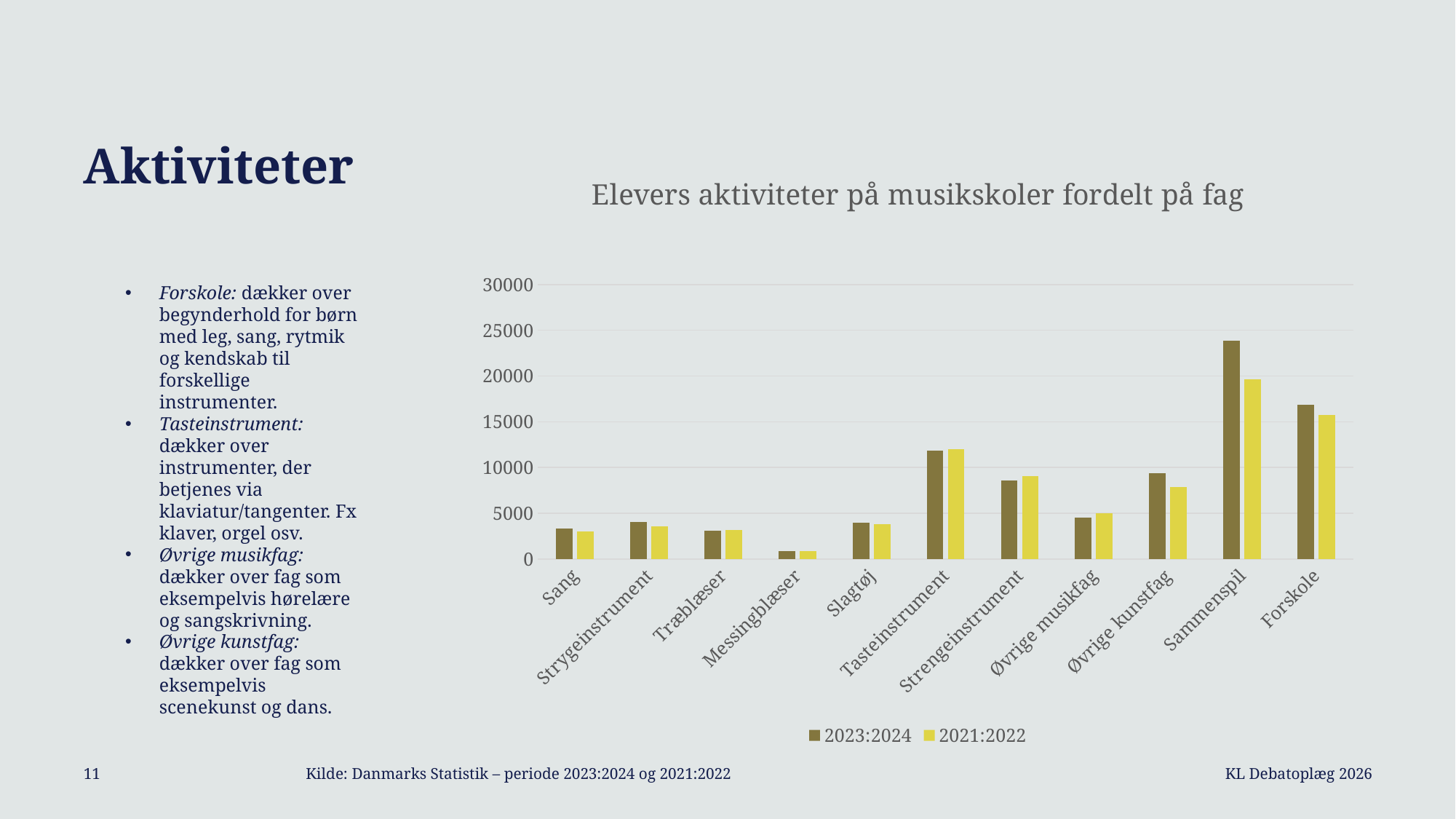
What kind of chart is shown on the slide? Bar chart Which category has the highest value for 2023:2024? Sammenspil Is the value for Sammenspil in 2023:2024 greater or less than 20000? greater Is the value for Forskole in 2023:2024 greater or less than 15000? greater What is the title of the chart? Elevers aktiviteter på musikskoler fordelt på fag Which is larger in 2023:2024, Tasteinstrument or Strengeinstrument? Tasteinstrument How many categories are shown on the x axis? 11 Is the value for Tasteinstrument in 2021:2022 greater or less than 10000? greater Which category has the lowest value for 2021:2022? Messingblæser How many series does the legend list? 2 For Sammenspil, which series has the larger value, 2023:2024 or 2021:2022? 2023:2024